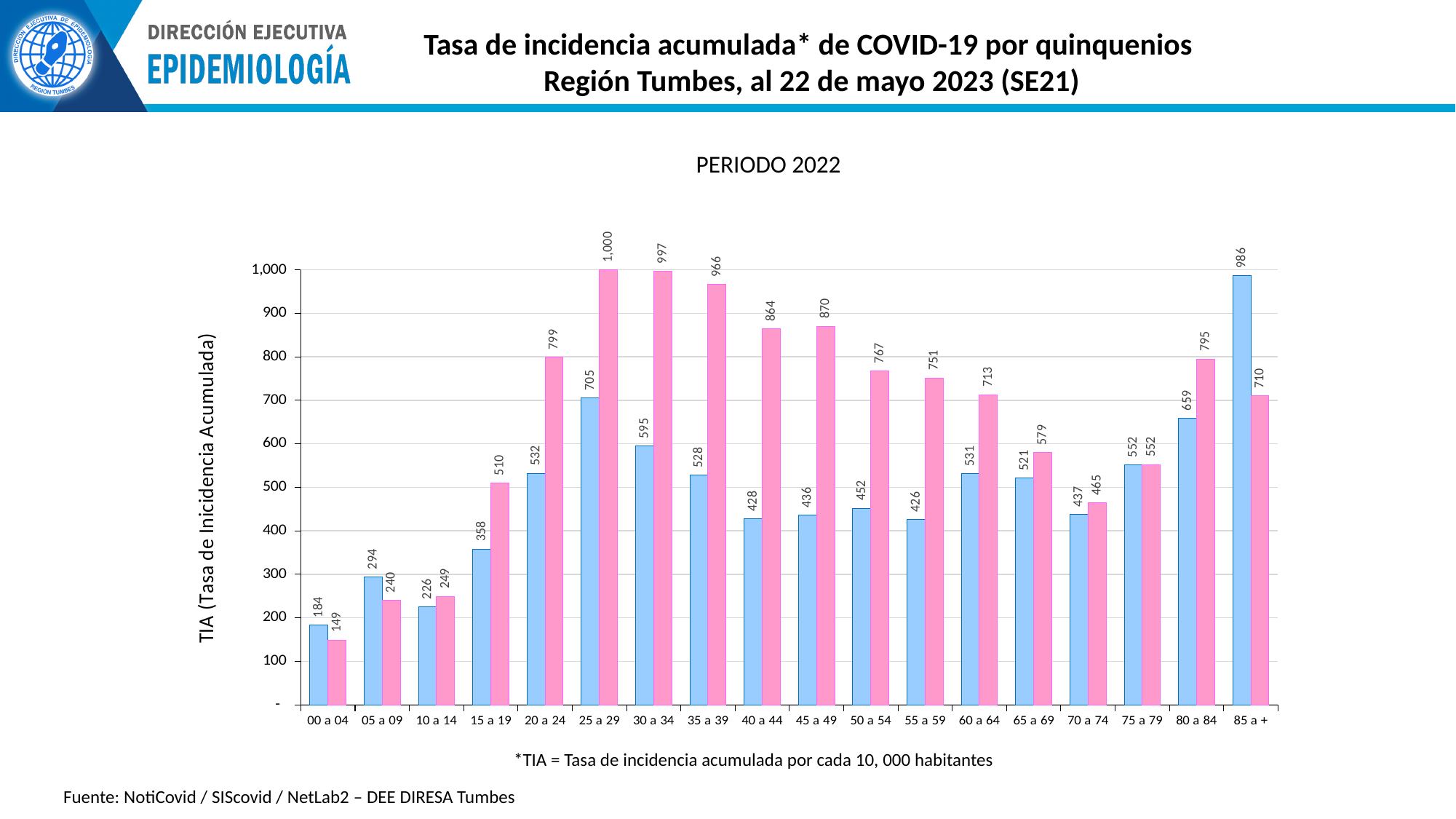
What is the value of the pink bar for the 40 a 44 age group? 864 How many age groups are shown on the x axis? 18 What is the value of the blue bar for the 25 a 29 age group? 705 What is the title shown above the chart? PERIODO 2022 What is the value of the blue bar for the 85 a + age group? 986 For the 10 a 14 age group, which bar is larger, the blue or the pink? pink What kind of chart is shown on the slide? bar chart What is the difference between the blue bars for 80 a 84 and 75 a 79? 107 What is the difference between the pink bar and the blue bar for the 85 a + age group? 276 What is the label of the y axis? TIA (Tasa de Incidencia Acumulada) Which age group has the highest pink bar? 25 a 29 Which age group has the lowest blue bar? 00 a 04